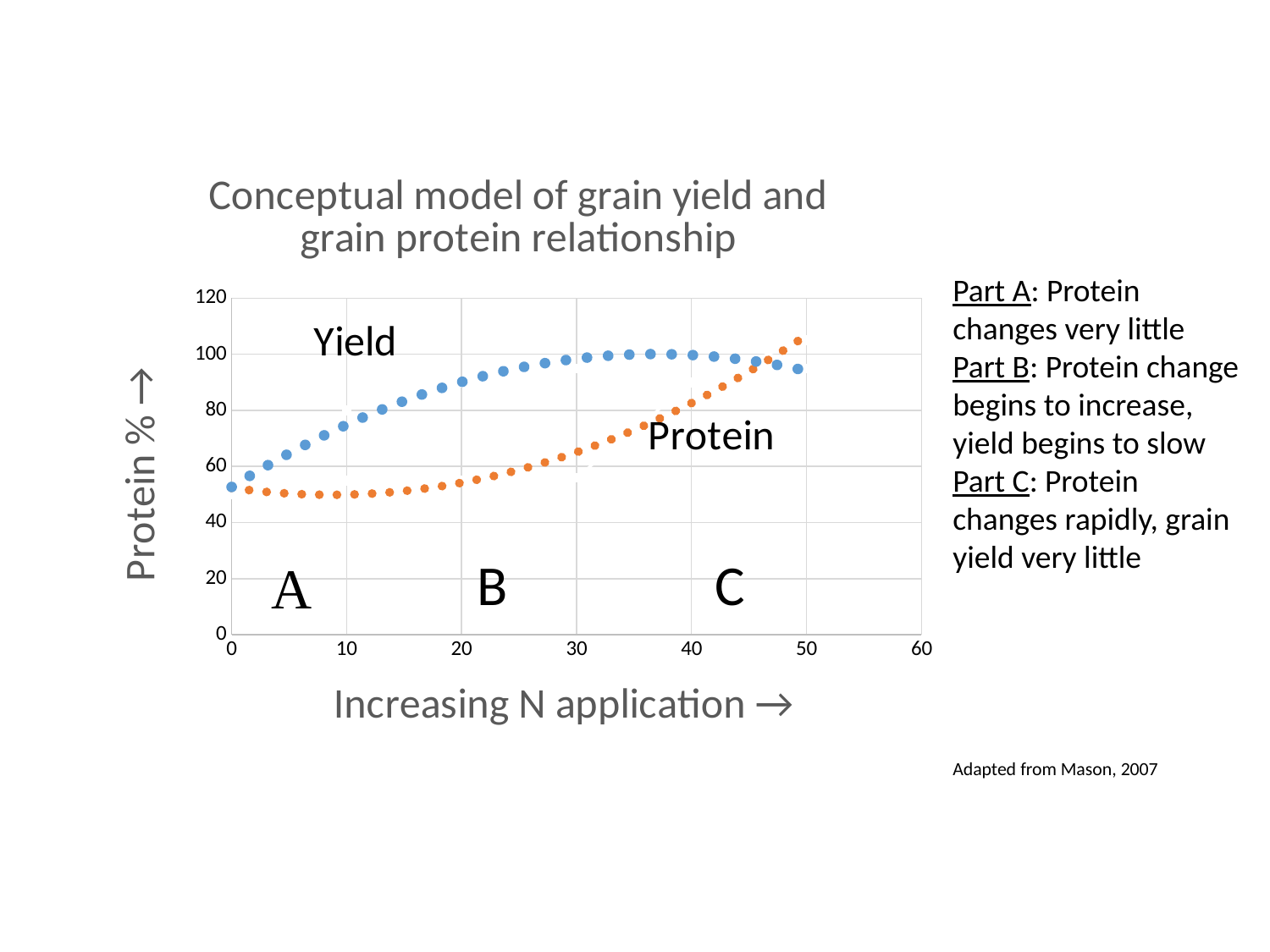
Is the Yield value at an N application of 0 greater or less than 60? less Which series reaches the highest value on the chart? Protein What is the label of the x axis? Increasing N application → What is the title of the chart? Conceptual model of grain yield and grain protein relationship Is the Protein value at an N application of 10 greater or less than 60? less At an N application of 20, which series has the higher value, Yield or Protein? Yield Does the Protein series rise or fall as N application increases along the x axis? Rises At an N application of 50, which series has the higher value, Yield or Protein? Protein Is the Yield value at an N application of 30 greater or less than 80? greater How many data series are plotted on the chart? 2 What kind of chart is shown on the slide? Scatter chart